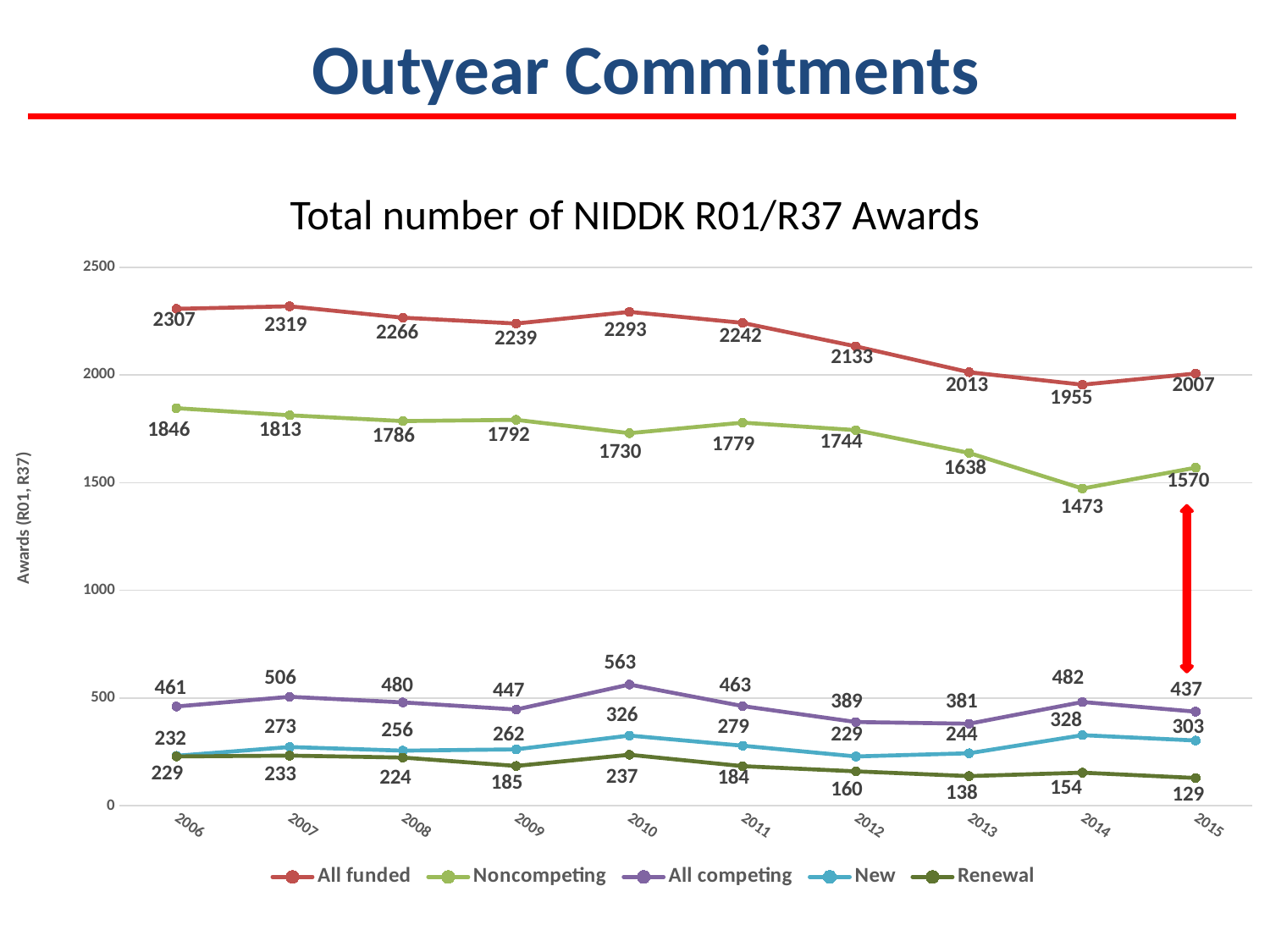
What is the value for All competing in 2010? 563 What is the value for Noncompeting in 2014? 1473 How many years are shown on the x axis? 10 Which is larger, the All competing value in 2014 or in 2015? 2014 What is the difference between the All funded value in 2007 and in 2015? 312 How many series does the legend list? 5 What is the value for Renewal in 2015? 129 In which year is the New series at its highest? 2014 What is the value for All funded in 2006? 2307 In which year is the All funded series at its lowest? 2014 What kind of chart is shown on the slide? Line chart What is the title of the chart? Total number of NIDDK R01/R37 Awards